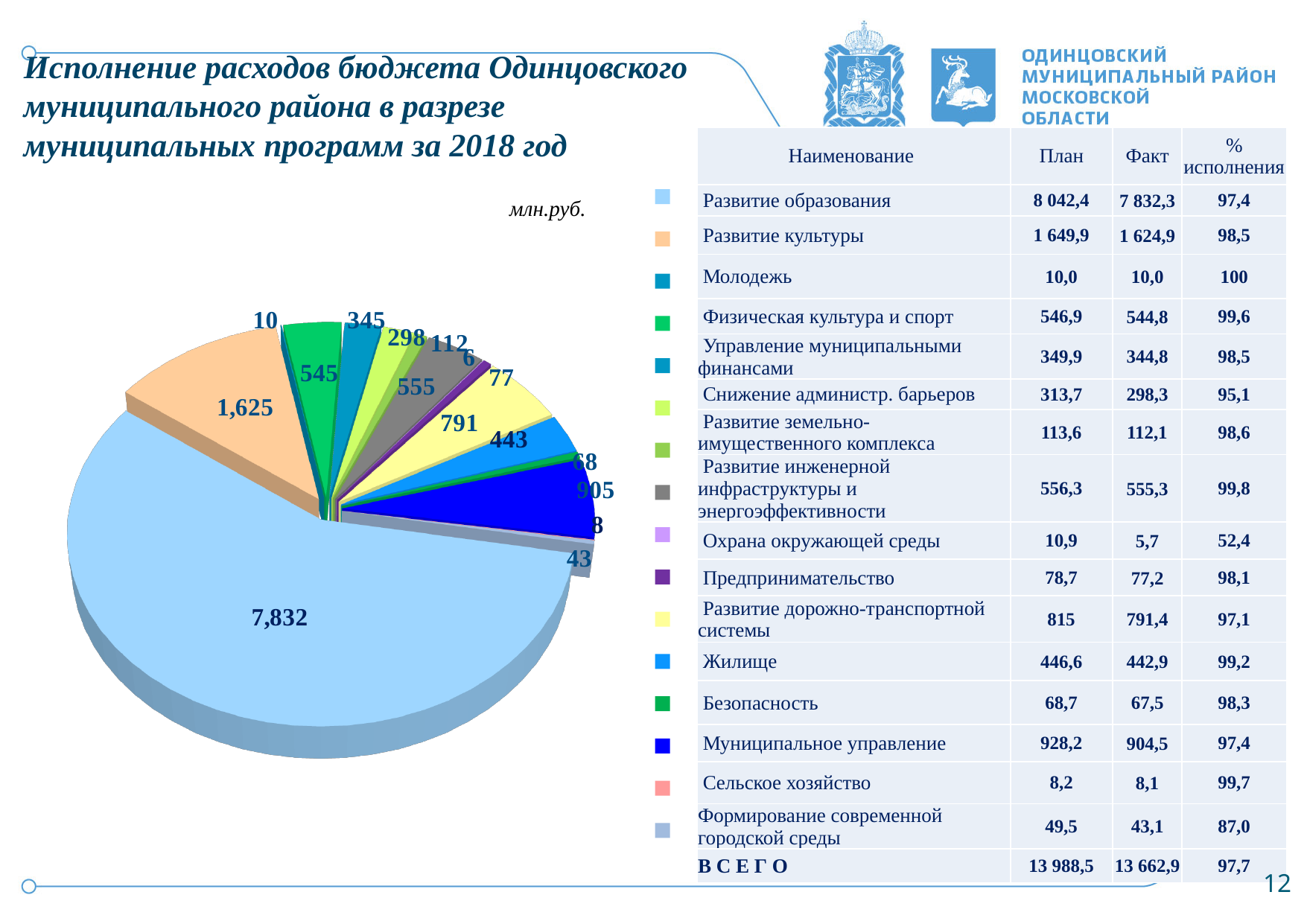
What year does the chart title say the budget expenditure data refers to? 2018 What is the value of the largest slice of the pie chart? 7,832 How many slices does the pie chart have? 16 What unit of measurement is indicated for the pie chart? млн.руб. What is the difference between the 7,832 slice and the 1,625 slice in the pie chart? 6,207 What is the value of the smallest slice of the pie chart? 6 Which program does the largest slice of the pie chart (7,832) correspond to? Развитие образования What kind of chart is shown on the slide? pie chart Which slice is larger in the pie chart: the one labelled 905 or the one labelled 791? 905 What value is labelled on the orange slice (Развитие культуры) of the pie chart? 1,625 What value is labelled on the dark blue slice (Муниципальное управление) of the pie chart? 905 What value is labelled on the yellow slice (Развитие дорожно-транспортной системы) of the pie chart? 791